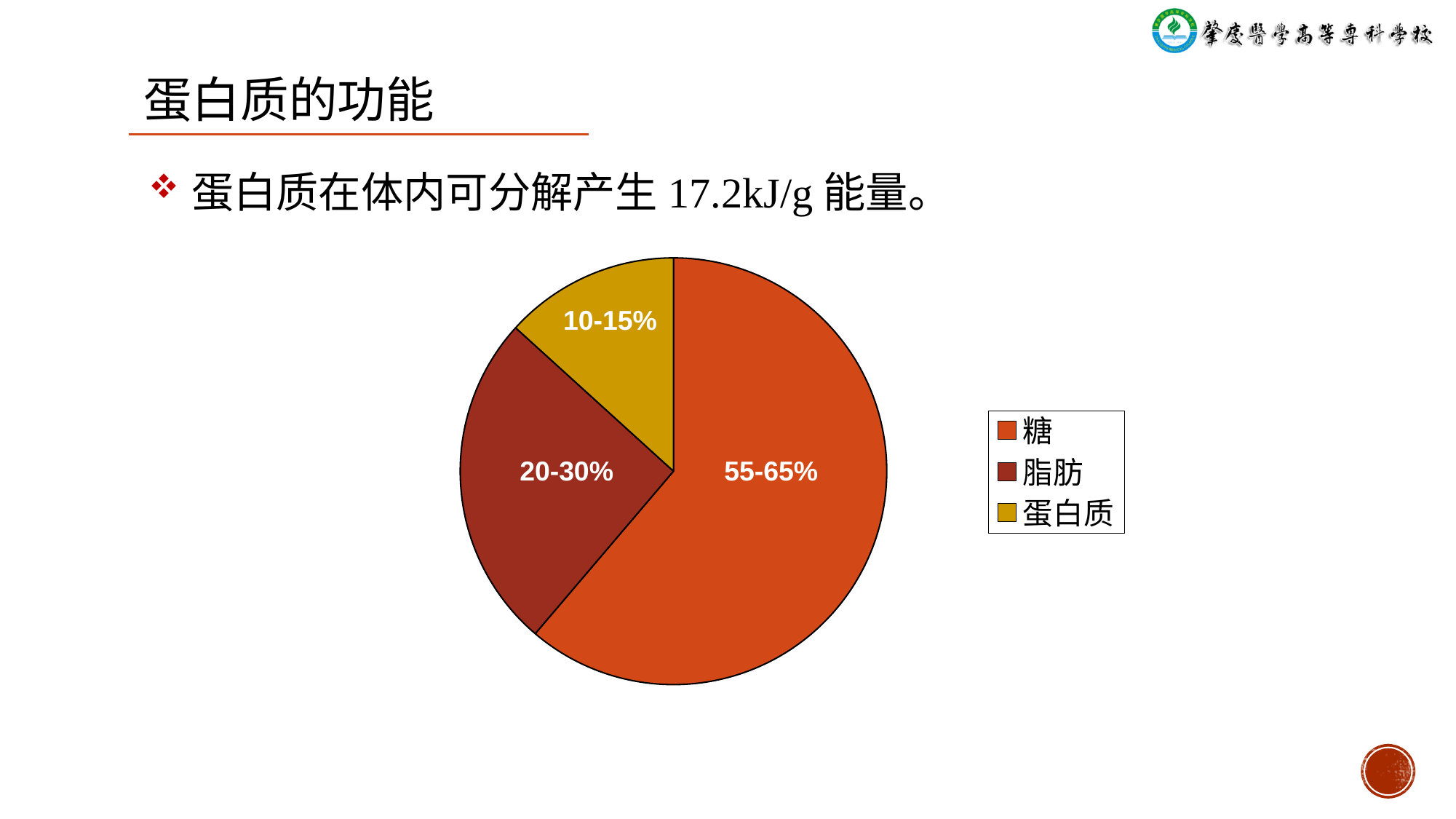
Which category has the largest slice in the pie chart? 糖 Which slice is larger in the pie chart, 脂肪 or 蛋白质? 脂肪 What kind of chart is shown on the slide? pie chart Which category is shown in yellow in the pie chart? 蛋白质 How many slices does the pie chart have? 3 Which slice is larger in the pie chart, 糖 or 脂肪? 糖 What is the labelled share for 脂肪 in the pie chart? 20-30% What is the labelled share for 糖 in the pie chart? 55-65% What is the labelled share for 蛋白质 in the pie chart? 10-15% Which category has the smallest slice in the pie chart? 蛋白质 How many entries does the legend of the pie chart list? 3 Which category is shown in dark red in the pie chart? 脂肪